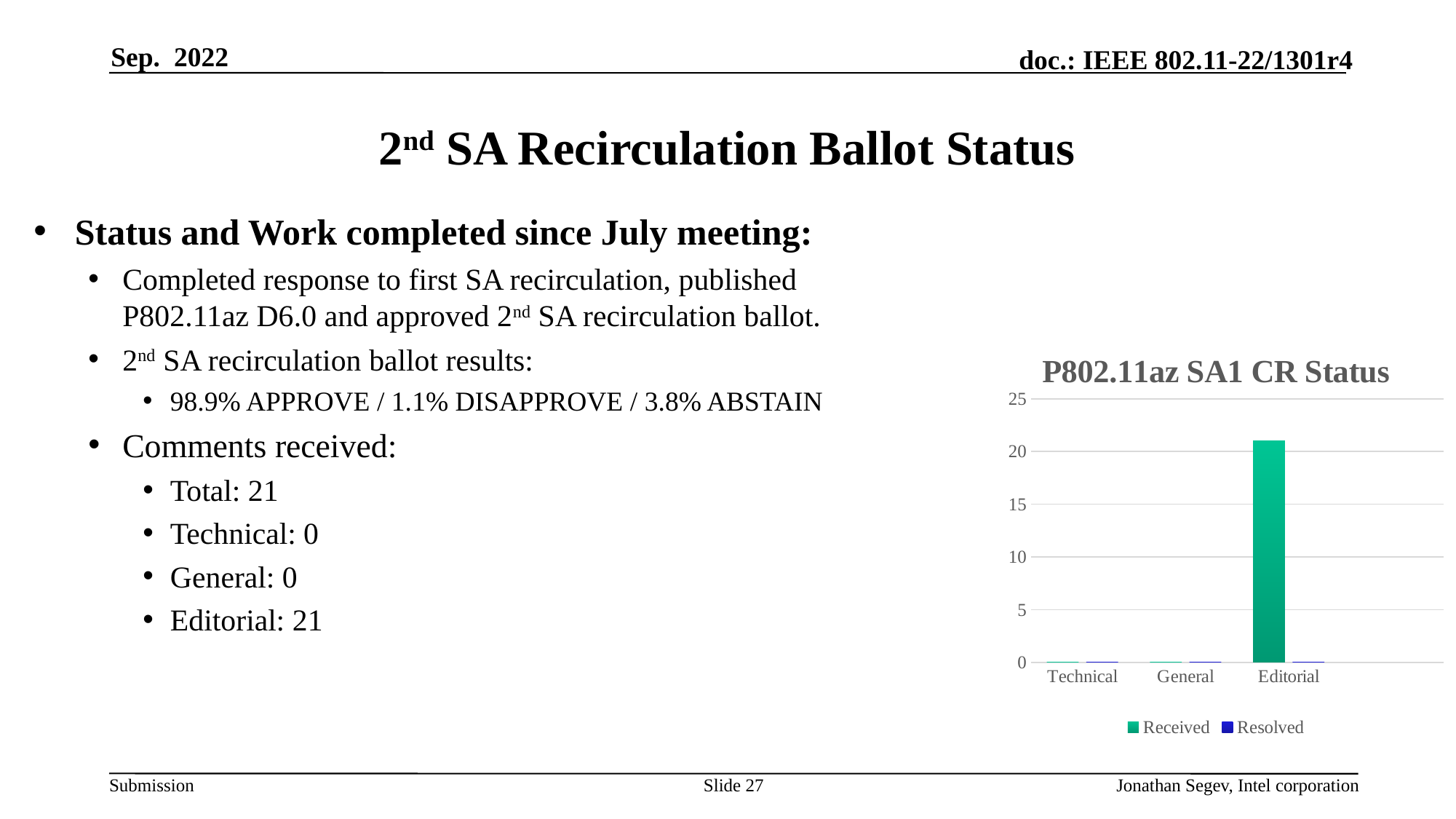
What are the two series named in the chart legend? Received and Resolved What kind of chart is shown on the slide? bar chart Is the Received value for Editorial greater or less than 20? greater Is the Received value for Technical greater or less than 5? less How many categories are shown on the x axis of the chart? 3 Which is larger in the chart, the Received value for Editorial or the Received value for Technical? Editorial What is the title of the chart? P802.11az SA1 CR Status Which category has the highest Received value in the chart? Editorial Is the Received value for Editorial greater or less than 25? less What is the highest value shown on the chart's vertical axis? 25 How many series does the chart legend list? 2